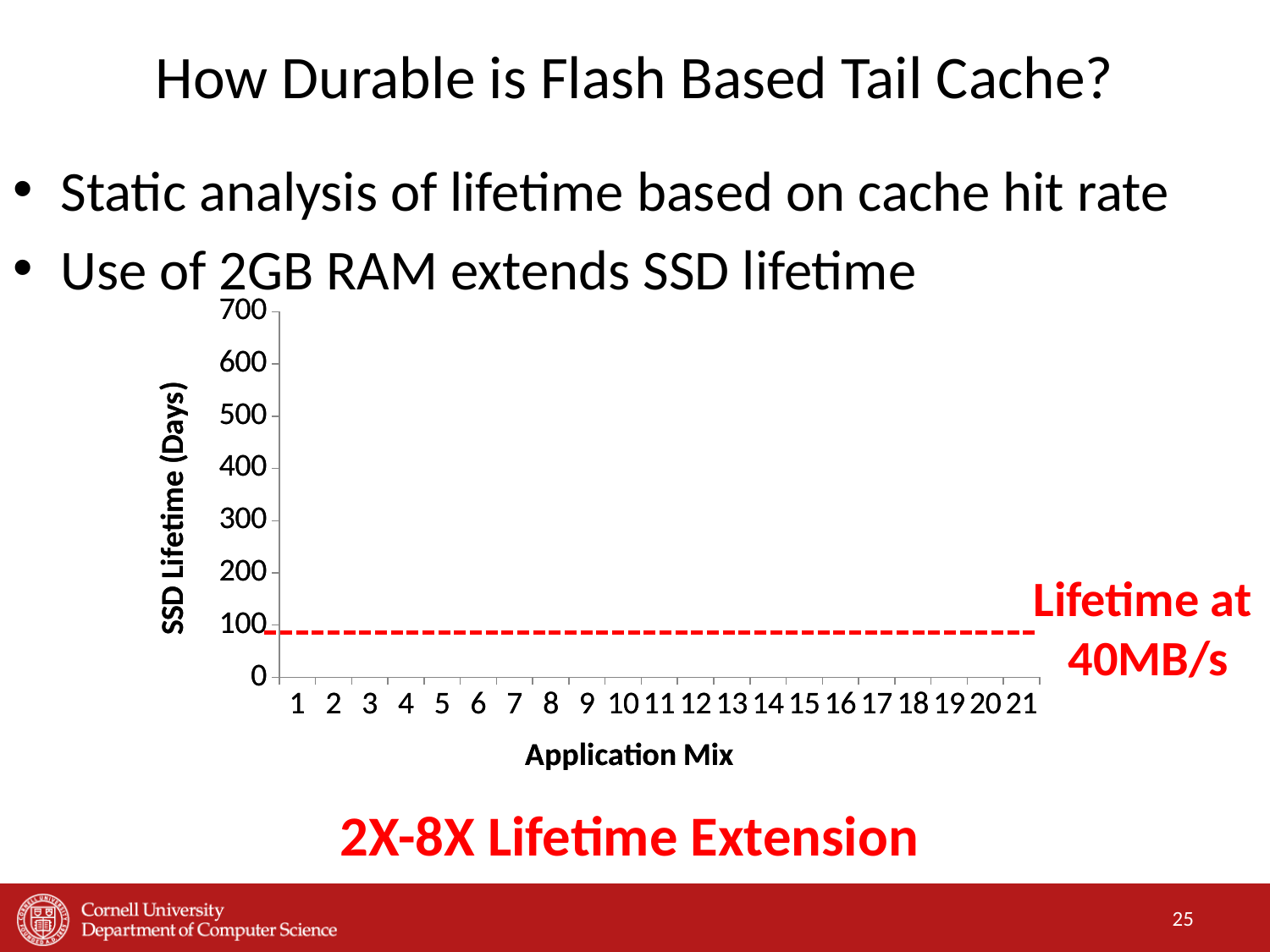
What is the label of the y axis of the chart? SSD Lifetime (Days) Is the dashed red line marking 'Lifetime at 40MB/s' greater or less than 100 days? less How many application mixes are listed along the x axis of the chart? 21 What is the label of the x axis of the chart? Application Mix